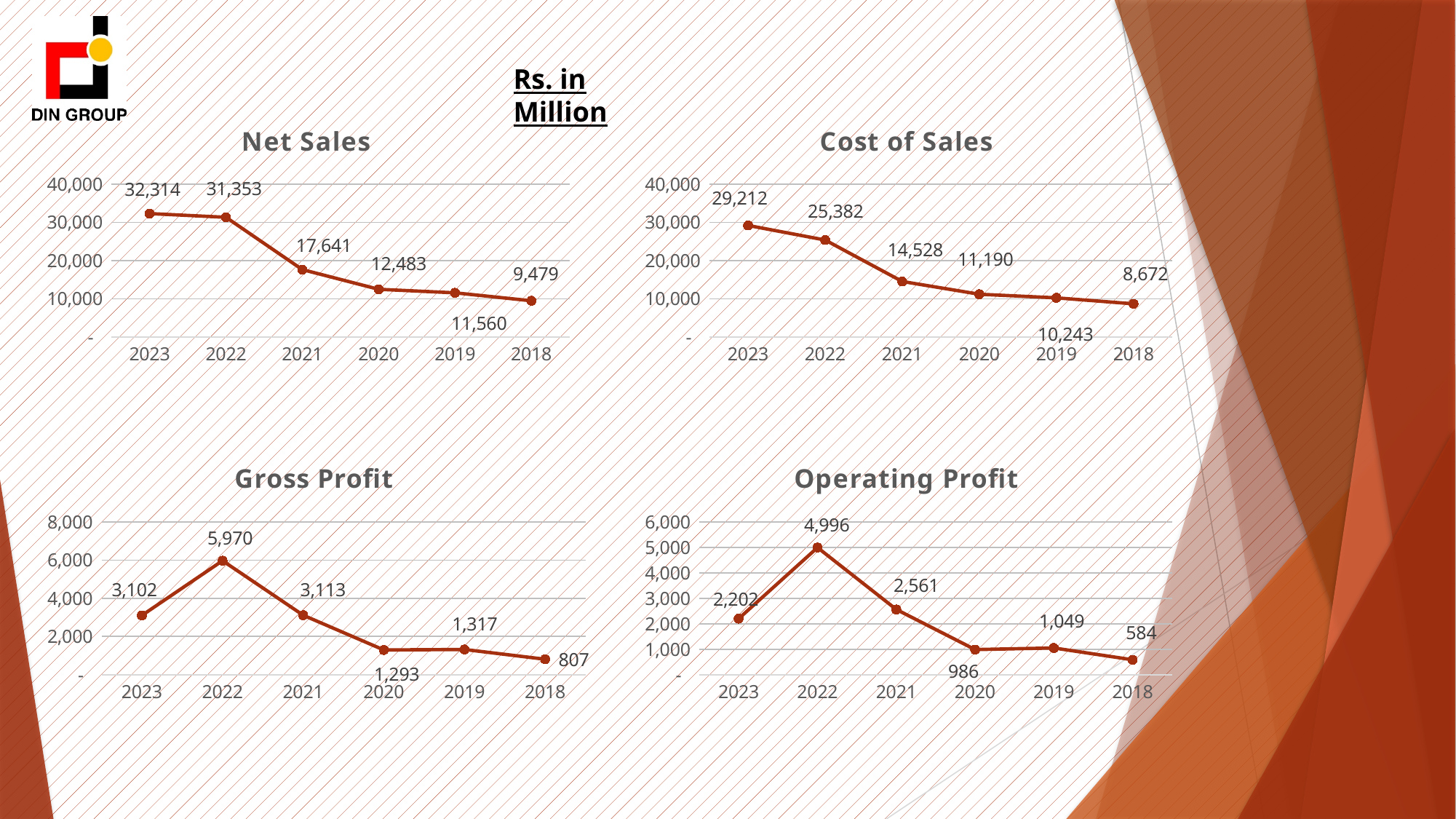
How many years are plotted in the Net Sales chart? 6 In the Cost of Sales chart, is the value for 2022 greater or less than 20,000? greater In the Gross Profit chart, which year has the highest value? 2022 What unit is stated at the top of the slide for the charts? Rs. in Million In the Operating Profit chart, which year has the lowest value? 2018 In the Operating Profit chart, what is the difference between the 2022 and 2021 values? 2,435 In the Gross Profit chart, which is larger, the value for 2023 or the value for 2021? 2021 In the Net Sales chart, do the values rise or fall moving from left to right along the x axis? fall What kind of chart is the Operating Profit chart? line chart In the Net Sales chart, what is the difference between the 2023 and 2022 values? 961 In the Net Sales chart, what is the value for 2021? 17,641 In the Cost of Sales chart, what is the value for 2019? 10,243